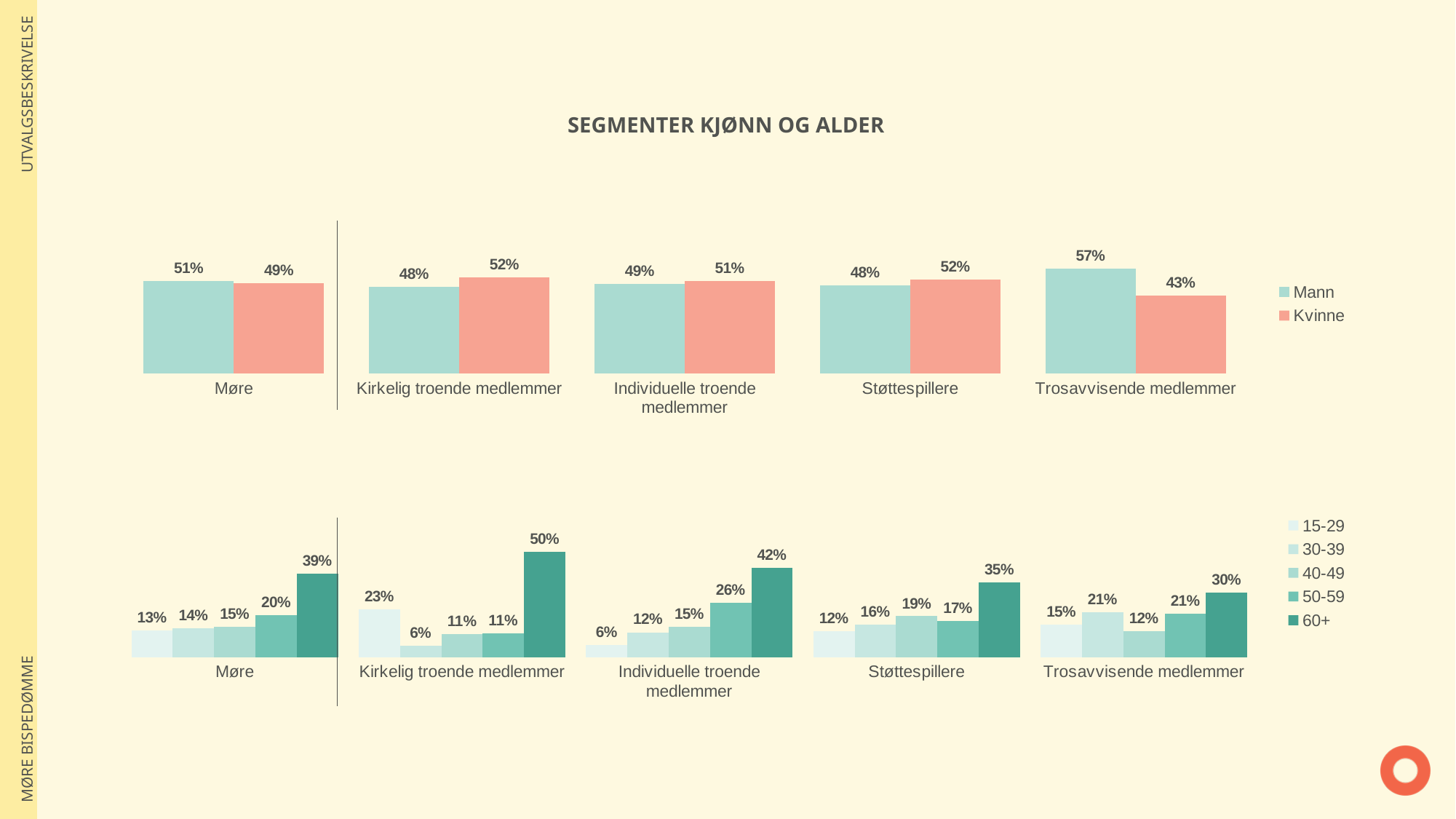
In the top chart (gender), what is the difference between Mann and Kvinne for Trosavvisende medlemmer? 14 percentage points In the top chart (gender), what is the value for Kvinne in the Kirkelig troende medlemmer category? 52% In the bottom chart (age), what is the value for the 15-29 group in the Individuelle troende medlemmer category? 6% In the bottom chart (age), how many categories are shown on the x axis? 5 In the bottom chart (age), how many series does the legend list? 5 In the top chart (gender), what is the value for Mann in the Trosavvisende medlemmer category? 57% In the top chart (gender), which category has the highest Mann value? Trosavvisende medlemmer In the bottom chart (age), which is larger for Støttespillere: the 30-39 group or the 50-59 group? 50-59 In the bottom chart (age), what is the value for the 60+ group in the Kirkelig troende medlemmer category? 50% In the bottom chart (age), which category has the lowest 60+ value? Trosavvisende medlemmer What type of chart is the top chart on the slide? Bar chart In the top chart (gender), how many series does the legend list? 2